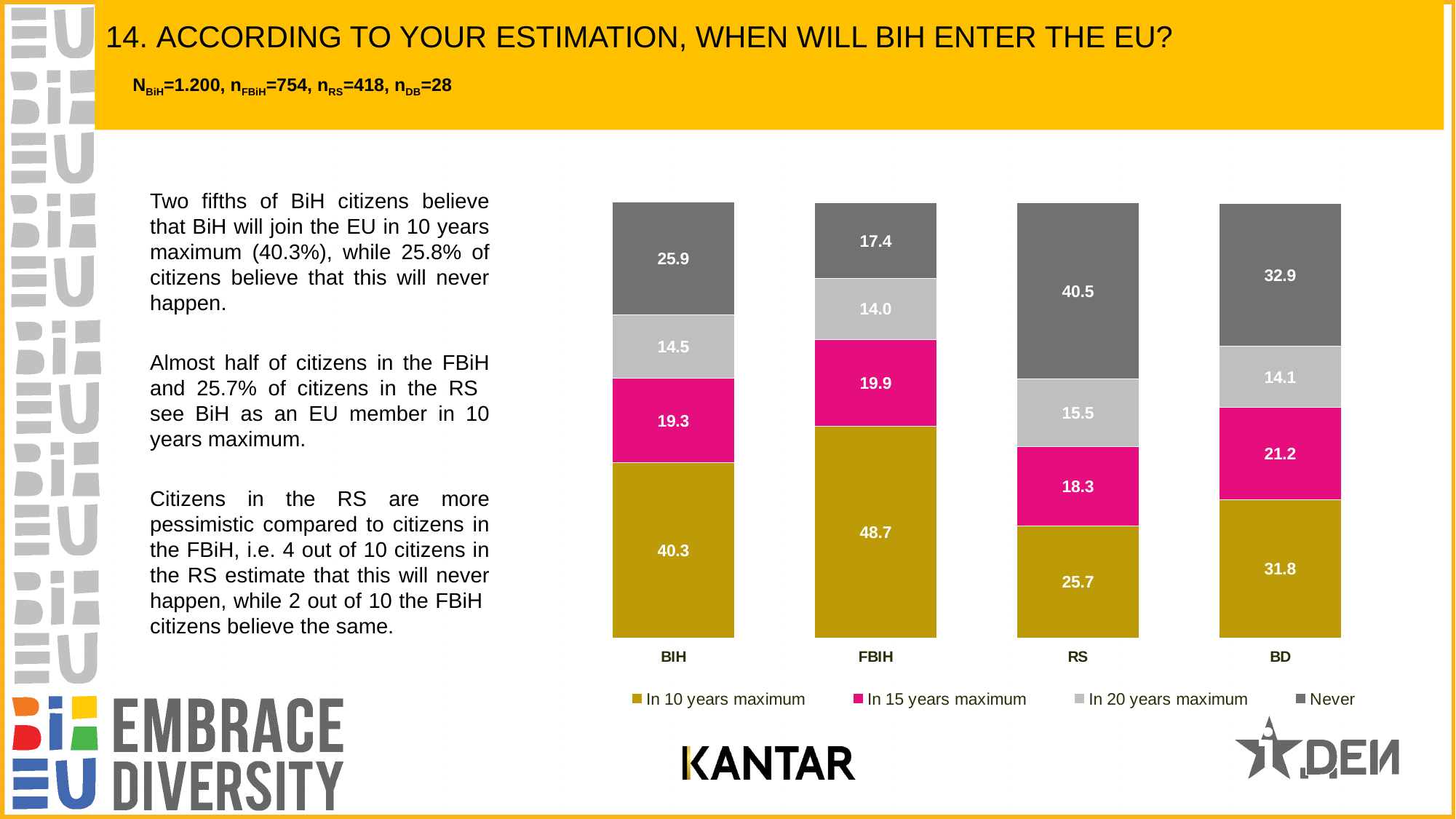
What is the value for 'In 15 years maximum' for BD? 21.2 What is the total of the stacked bar for BIH? 100.0 What is the difference between the 'Never' values for RS and FBIH? 23.1 Which category has the highest value for 'In 10 years maximum'? FBIH How many categories are shown on the x axis? 4 What is the value for 'In 10 years maximum' for FBIH? 48.7 Which is larger: the 'In 10 years maximum' value for BD or for RS? BD What kind of chart is shown on the slide? Stacked bar chart What is the value for 'In 20 years maximum' for BIH? 14.5 Which category has the lowest value for 'Never'? FBIH What is the value for 'Never' for RS? 40.5 How many series does the legend list? 4